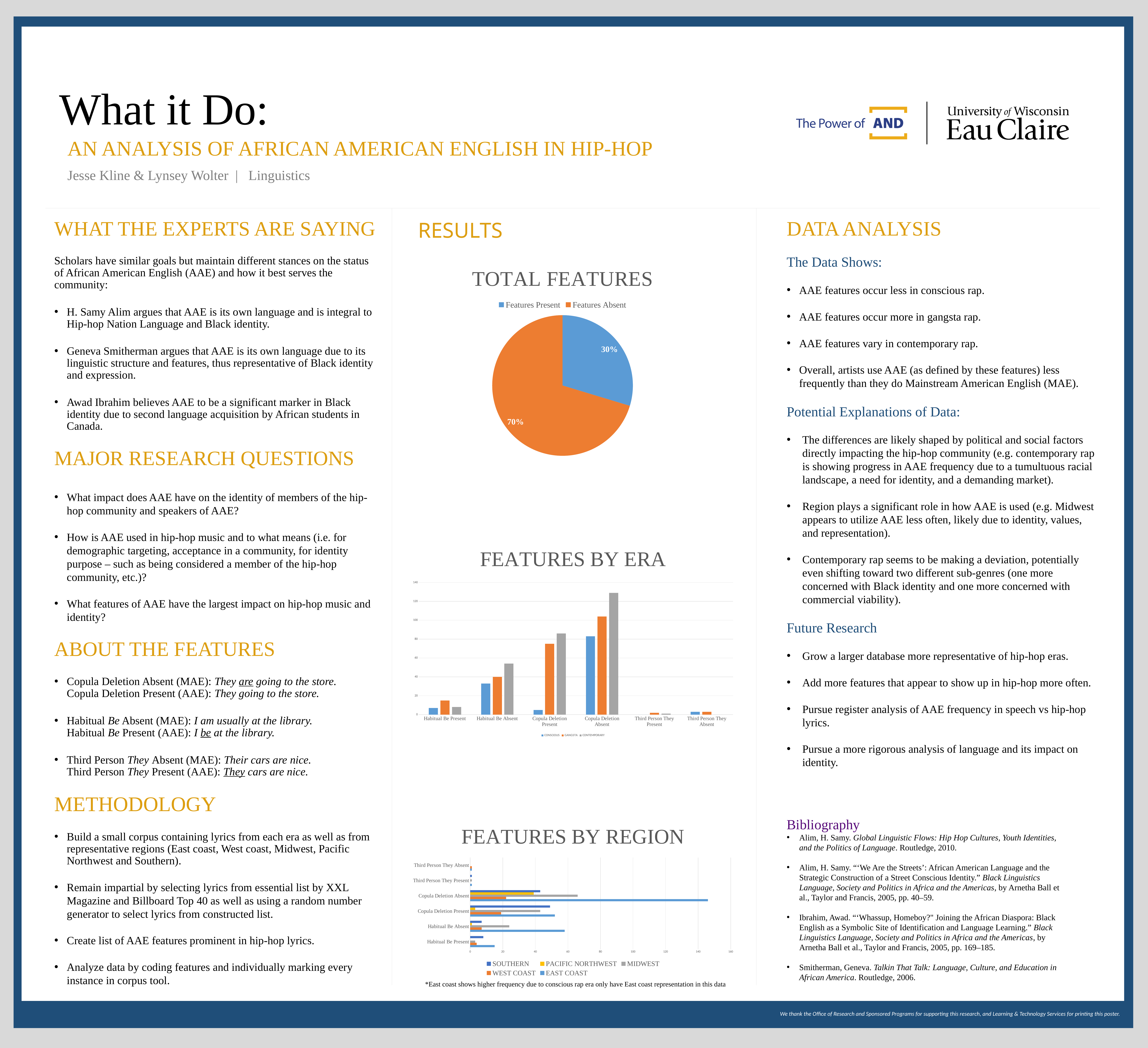
In the FEATURES BY REGION chart, is the EAST COAST value for Copula Deletion Absent greater or less than 140? greater In the FEATURES BY ERA chart, which is larger for Copula Deletion Present, the CONSCIOUS bar or the CONTEMPORARY bar? CONTEMPORARY In the FEATURES BY ERA chart, is the CONSCIOUS value for Copula Deletion Absent greater or less than 100? less How many categories are shown on the x axis of the FEATURES BY ERA chart? 6 In the TOTAL FEATURES pie chart, what percentage is shown for Features Absent? 70% In the TOTAL FEATURES pie chart, what percentage is shown for Features Present? 30% In the FEATURES BY ERA chart, which category has the tallest bar? Copula Deletion Absent In the TOTAL FEATURES pie chart, which slice is larger, Features Present or Features Absent? Features Absent What kind of chart is the TOTAL FEATURES chart? Pie chart How many series does the legend of the FEATURES BY ERA chart list? 3 What kind of chart is the FEATURES BY REGION chart? Bar chart How many series does the legend of the FEATURES BY REGION chart list? 5